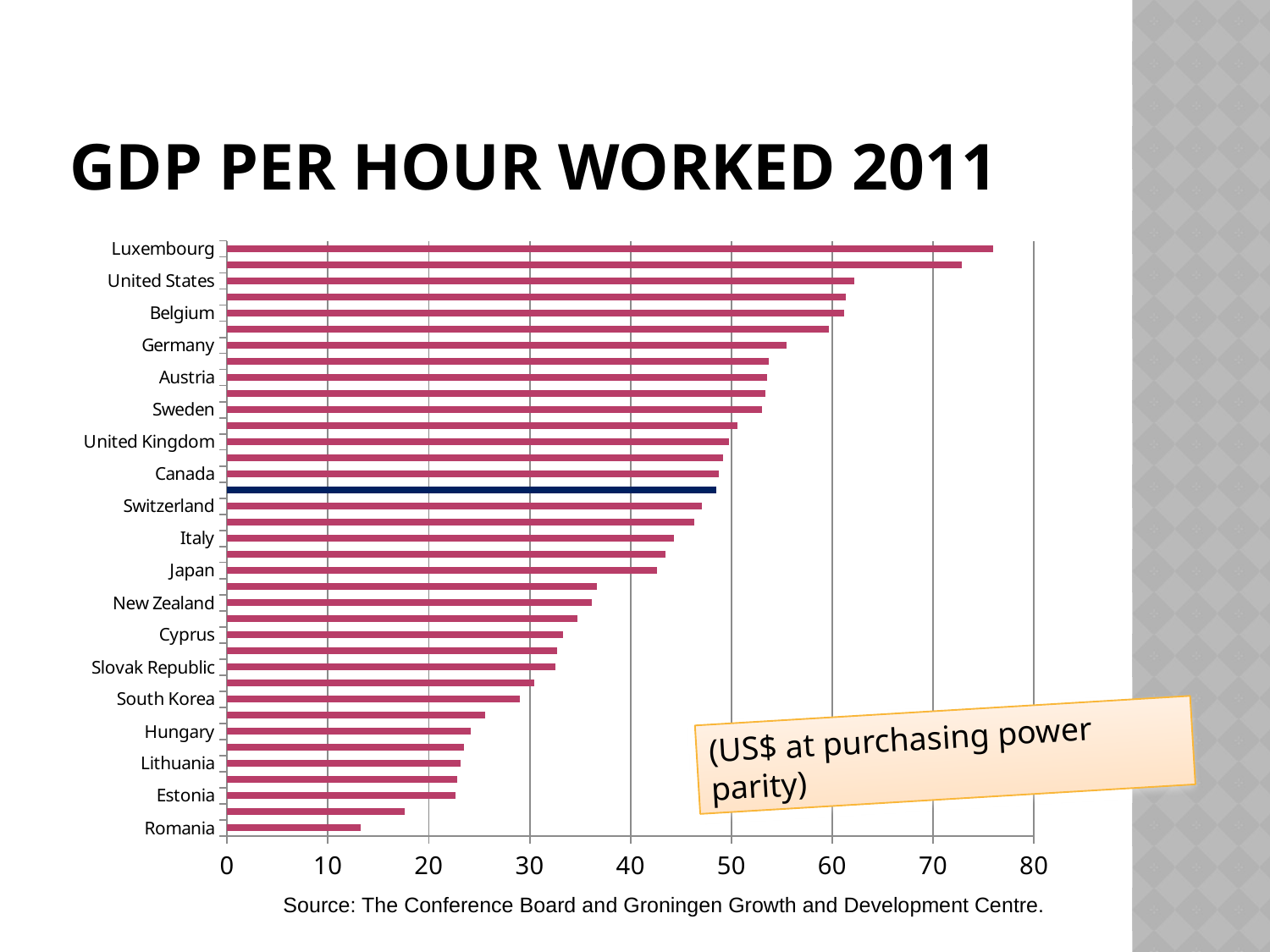
What kind of chart is shown on the slide? bar chart Is the value for Luxembourg greater or less than 70? greater Is the value for South Korea greater or less than 30? less In what unit are the values expressed, according to the callout on the slide? US$ at purchasing power parity Is the value for Romania greater or less than 20? less What is the title of the chart? GDP PER HOUR WORKED 2011 Which has a higher GDP per hour worked, the United States or Italy? United States Which country has the highest GDP per hour worked in the chart? Luxembourg Which has a lower GDP per hour worked, Estonia or Cyprus? Estonia Which country has the lowest GDP per hour worked in the chart? Romania